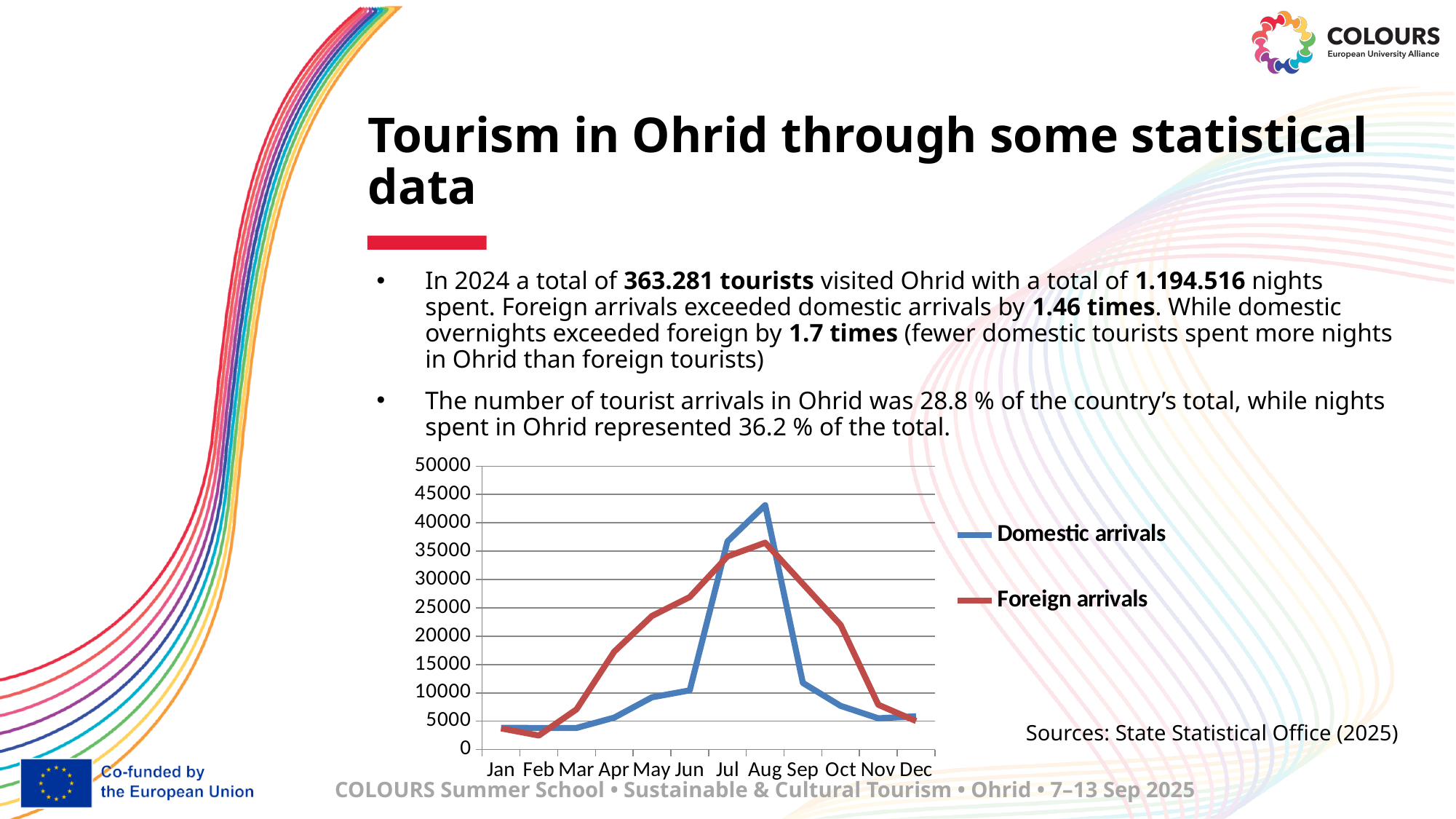
What kind of chart is shown on the slide? line chart Do Foreign arrivals rise or fall from January to August? rise Is the value for Domestic arrivals in August greater or less than 40000? greater How many months are plotted along the x axis of the chart? 12 In June, which series has the larger value, Domestic arrivals or Foreign arrivals? Foreign arrivals Is the value for Foreign arrivals in June greater or less than 25000? greater In which month do Foreign arrivals reach their highest value? Aug How many series does the chart's legend list? 2 In which month do Domestic arrivals reach their highest value? Aug What colour is the line for Foreign arrivals? red In August, which series has the larger value, Domestic arrivals or Foreign arrivals? Domestic arrivals In which month are Foreign arrivals at their lowest? Feb